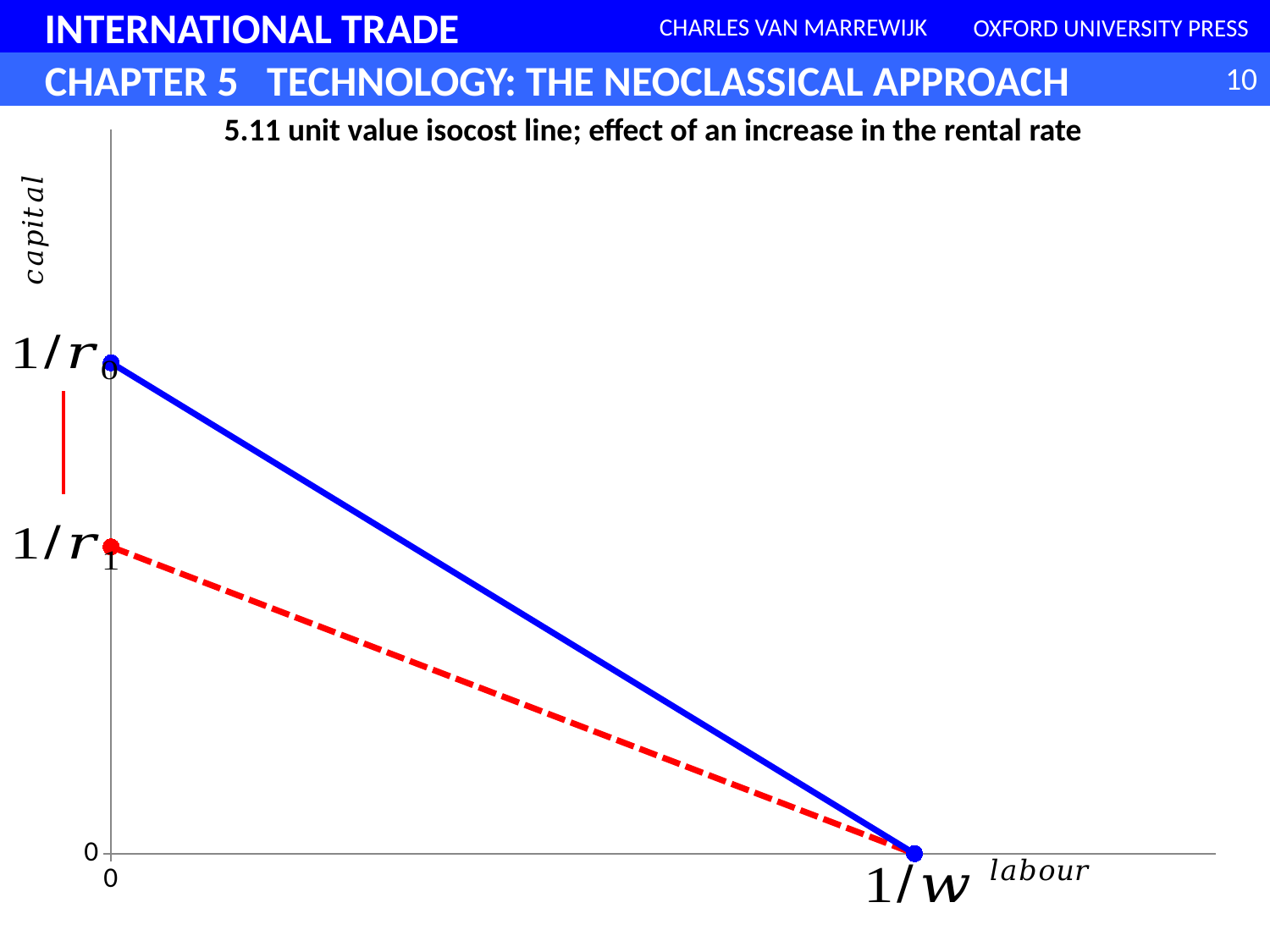
Which vertical intercept is higher on the capital axis, 1/r0 or 1/r1? 1/r0 What is the title of the chart? 5.11 unit value isocost line; effect of an increase in the rental rate How many lines are plotted on the chart? 2 What kind of chart is shown on the slide? line chart Which line is steeper, the solid blue line or the dashed red line? the solid blue line At what point on the labour axis do both lines meet? 1/w Which line has the higher intercept on the capital axis, the solid blue line or the dashed red line? the solid blue line What value is shown at the origin of the axes? 0 Do the plotted lines rise or fall as labour increases along the x axis? fall What is the label of the vertical axis? capital